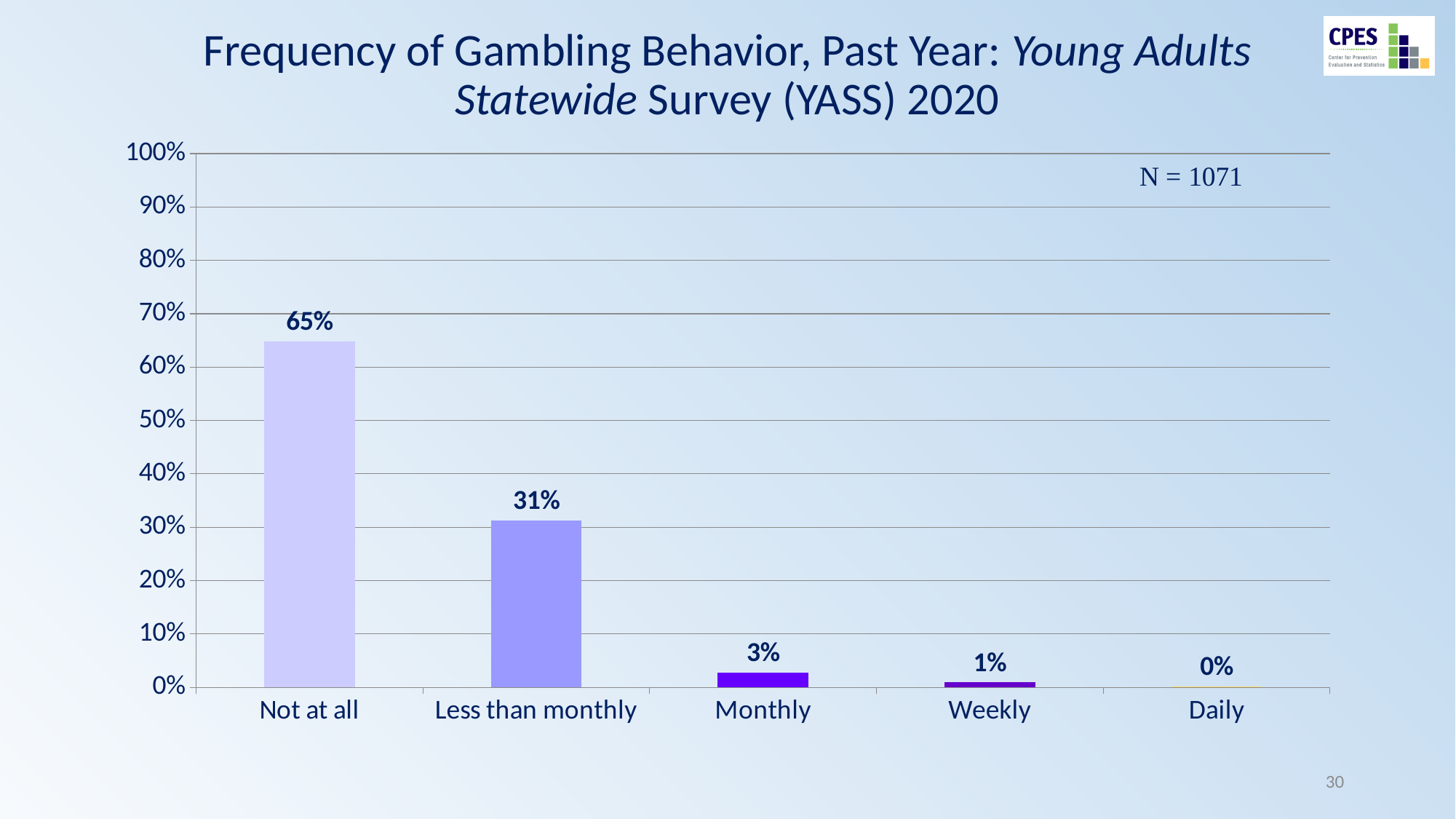
What is the difference between the 'Not at all' and 'Less than monthly' values? 34% How many categories are shown on the x axis? 5 What kind of chart is shown on the slide? Bar chart What is the value for 'Weekly'? 1% What sample size (N) is shown on the chart? N = 1071 Which is larger, the value for 'Monthly' or the value for 'Weekly'? Monthly What is the value shown for 'Less than monthly'? 31% Which category has the highest value? Not at all What is the value for 'Daily'? 0% What percentage of young adults reported gambling 'Not at all' in the past year? 65% What percentage is shown for 'Monthly' gambling? 3% Which category has the lowest value? Daily